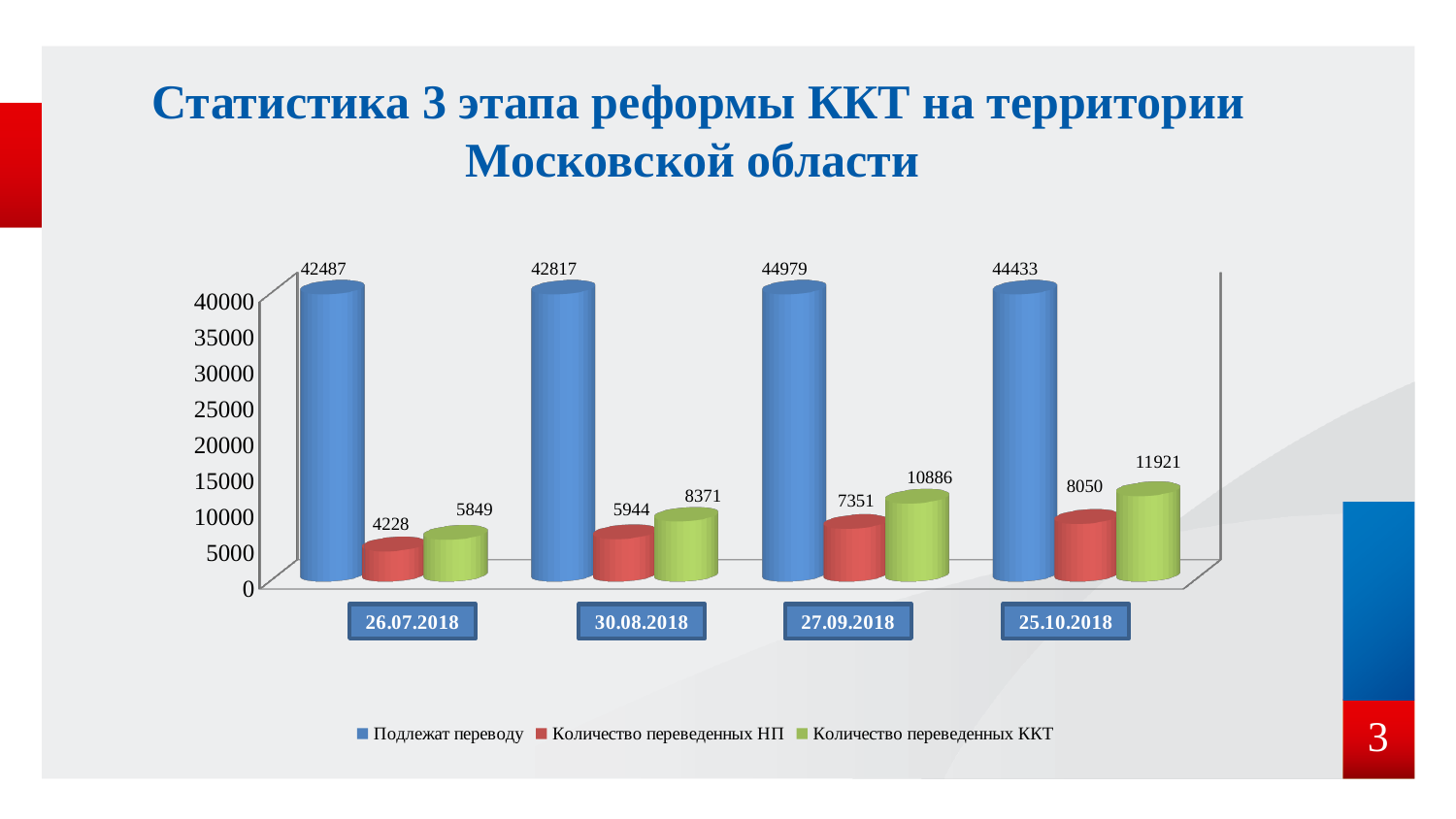
On which date is "Подлежат переводу" highest? 27.09.2018 What kind of chart is shown on the slide? Bar chart What is the value of "Количество переведенных НП" for 30.08.2018? 5944 What is the difference between "Количество переведенных ККТ" and "Количество переведенных НП" for 27.09.2018? 3535 Which is larger for 25.10.2018: "Количество переведенных НП" or "Количество переведенных ККТ"? Количество переведенных ККТ On which date is "Количество переведенных НП" lowest? 26.07.2018 Does "Количество переведенных ККТ" rise or fall from 26.07.2018 to 25.10.2018? Rise What is the value of "Подлежат переводу" for 26.07.2018? 42487 How many series does the legend list? 3 What is the value of "Количество переведенных ККТ" for 25.10.2018? 11921 How many dates are shown on the x axis? 4 What colour are the bars for "Количество переведенных НП"? Red